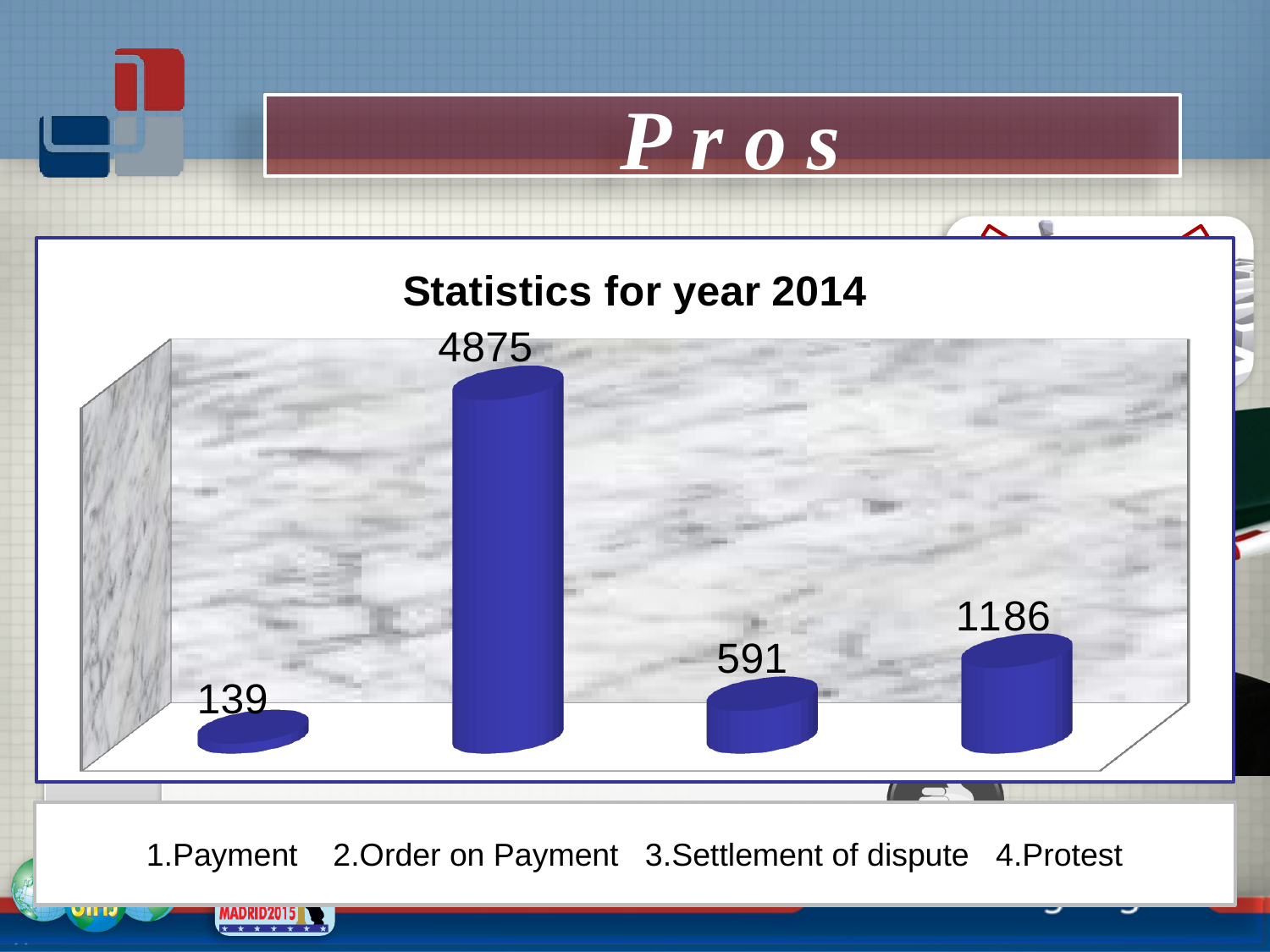
What is the value for Order on Payment (the second bar)? 4875 What is the value for Payment (the first bar)? 139 Which is larger, the value for Settlement of dispute or the value for Protest? Protest What is the title of the chart? Statistics for year 2014 What is the value for Settlement of dispute (the third bar)? 591 Which category has the highest value? Order on Payment What is the difference between the values for Settlement of dispute and Payment? 452 What is the value for Protest (the fourth bar)? 1186 What type of chart is shown on the slide? bar chart What is the difference between the values for Order on Payment and Protest? 3689 How many bars does the chart show? 4 Which category has the lowest value? Payment